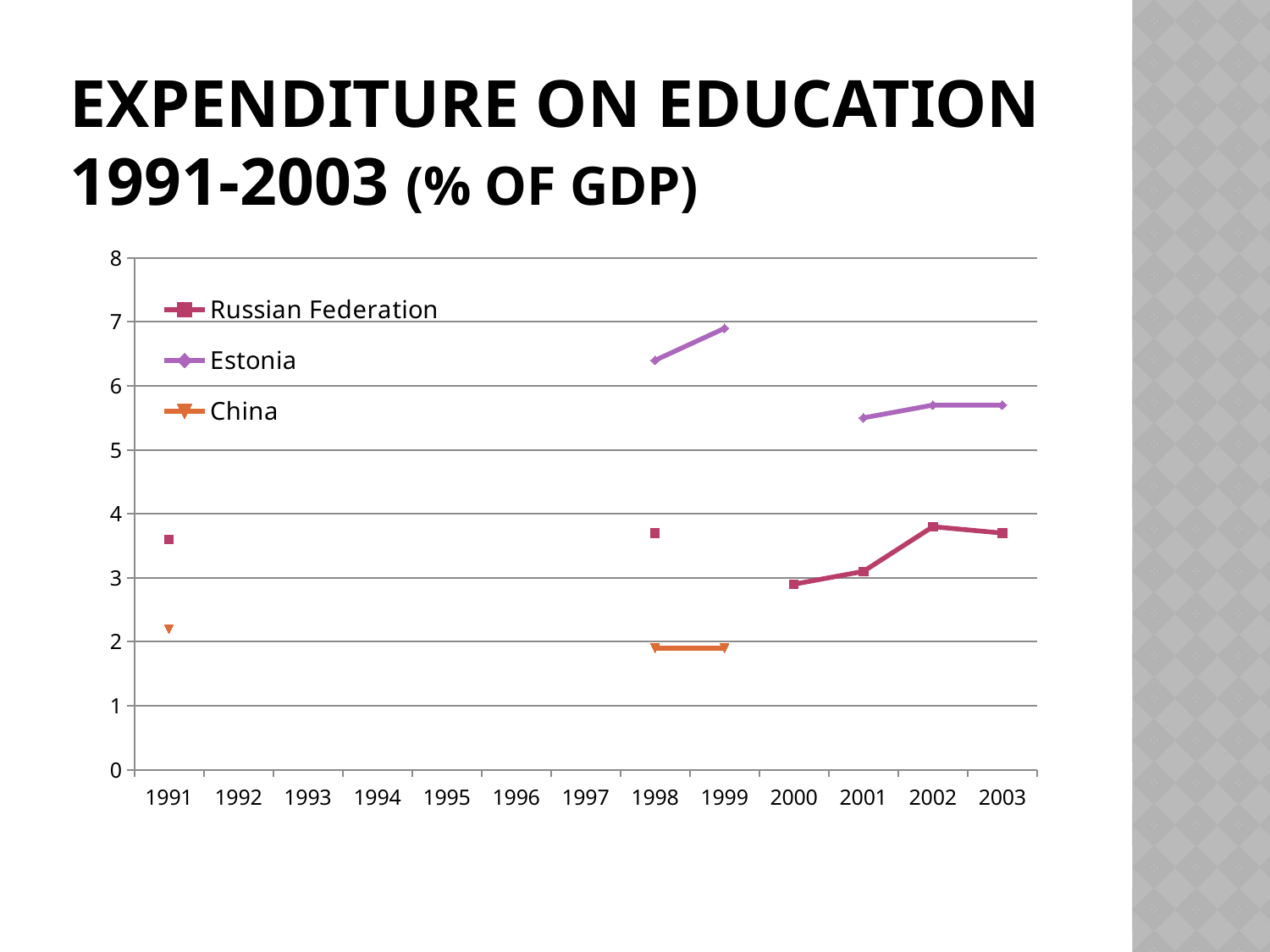
What is the title of the chart? Expenditure on Education 1991-2003 (% of GDP) Does the Russian Federation line rise or fall from 2000 to 2002? rise In which year does Estonia reach its highest value? 1999 Which series has the highest value in 1999? Estonia Which is larger in 2002, the value for Estonia or the value for the Russian Federation? Estonia Which series has the lowest value in 1998? China Is the value for the Russian Federation in 2002 greater or less than 4? less What kind of chart is shown on the slide? line chart How many series does the legend list? 3 How many years are labelled on the x axis? 13 Is the value for Estonia in 1999 greater or less than 6? greater Is the value for Estonia in 2001 greater or less than 5? greater